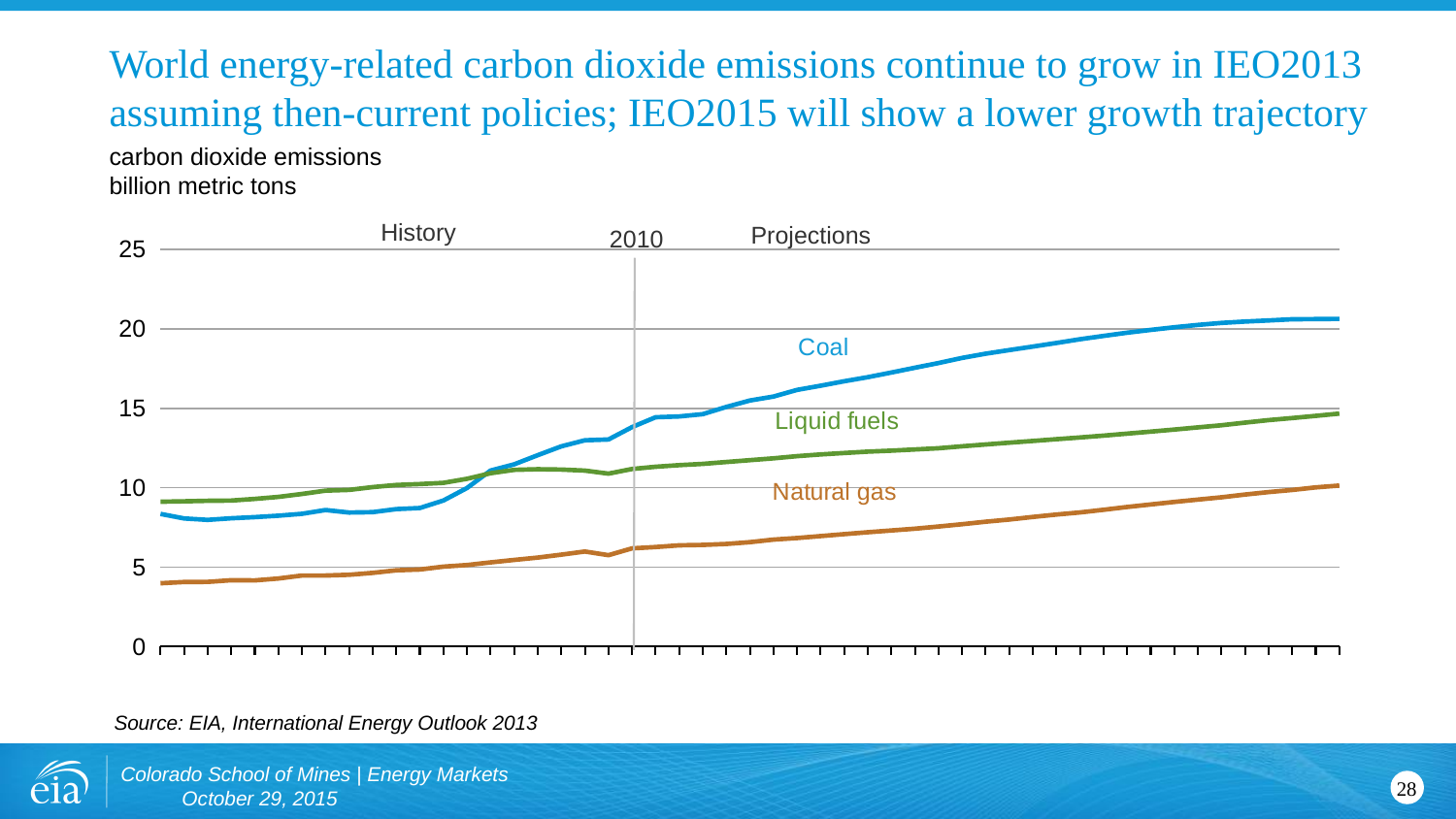
Do the Coal emissions rise or fall over the projection period? rise At the start of the history period, which is larger: Coal or Liquid fuels? Liquid fuels Is the value for Liquid fuels in 2010 greater or less than 10? greater What unit is used for the carbon dioxide emissions on the chart? billion metric tons Is the value for Natural gas in 2010 greater or less than 5? greater At the end of the projection period, which is larger: Coal or Liquid fuels? Coal Is the value for Coal at the end of the projection period greater or less than 15? greater Which series has the highest carbon dioxide emissions at the end of the projection period? Coal Which series has the lowest carbon dioxide emissions throughout the chart? Natural gas What kind of chart is shown on the slide? line chart How many series are plotted on the chart? 3